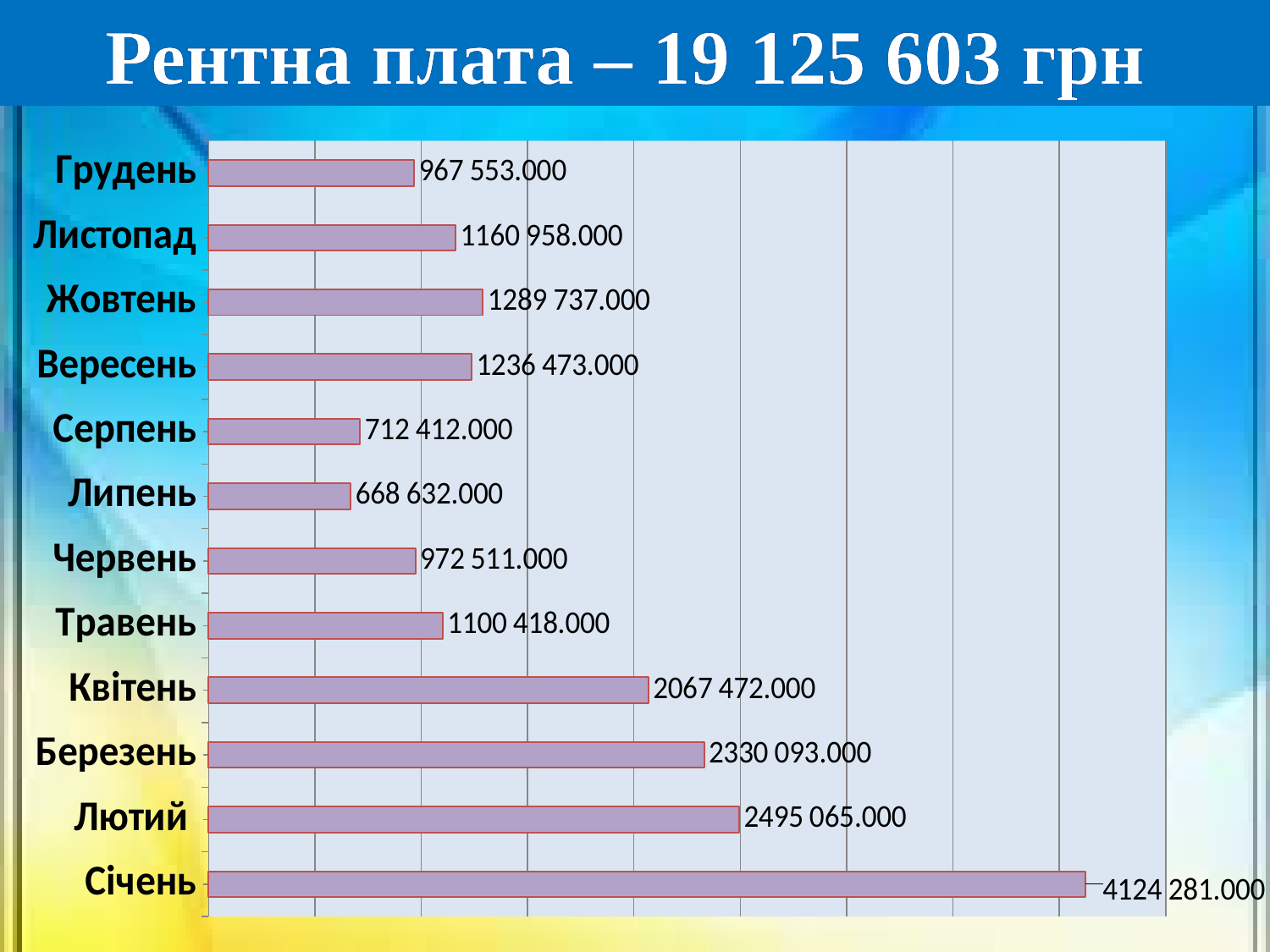
What is the value for Жовтень? 1289 737.000 What is the value for Січень? 4124 281.000 How many months (categories) are shown in the chart? 12 What is the value for Травень? 1100 418.000 Which month has the lowest value? Липень What is the value for Липень? 668 632.000 What is the difference between the values for Лютий and Березень? 164 972.000 Which month has the highest value? Січень What is the title of the slide? Рентна плата – 19 125 603 грн What type of chart is shown on the slide? bar chart Which is larger, the value for Лютий or the value for Березень? Лютий Which is larger, the value for Грудень or the value for Червень? Червень